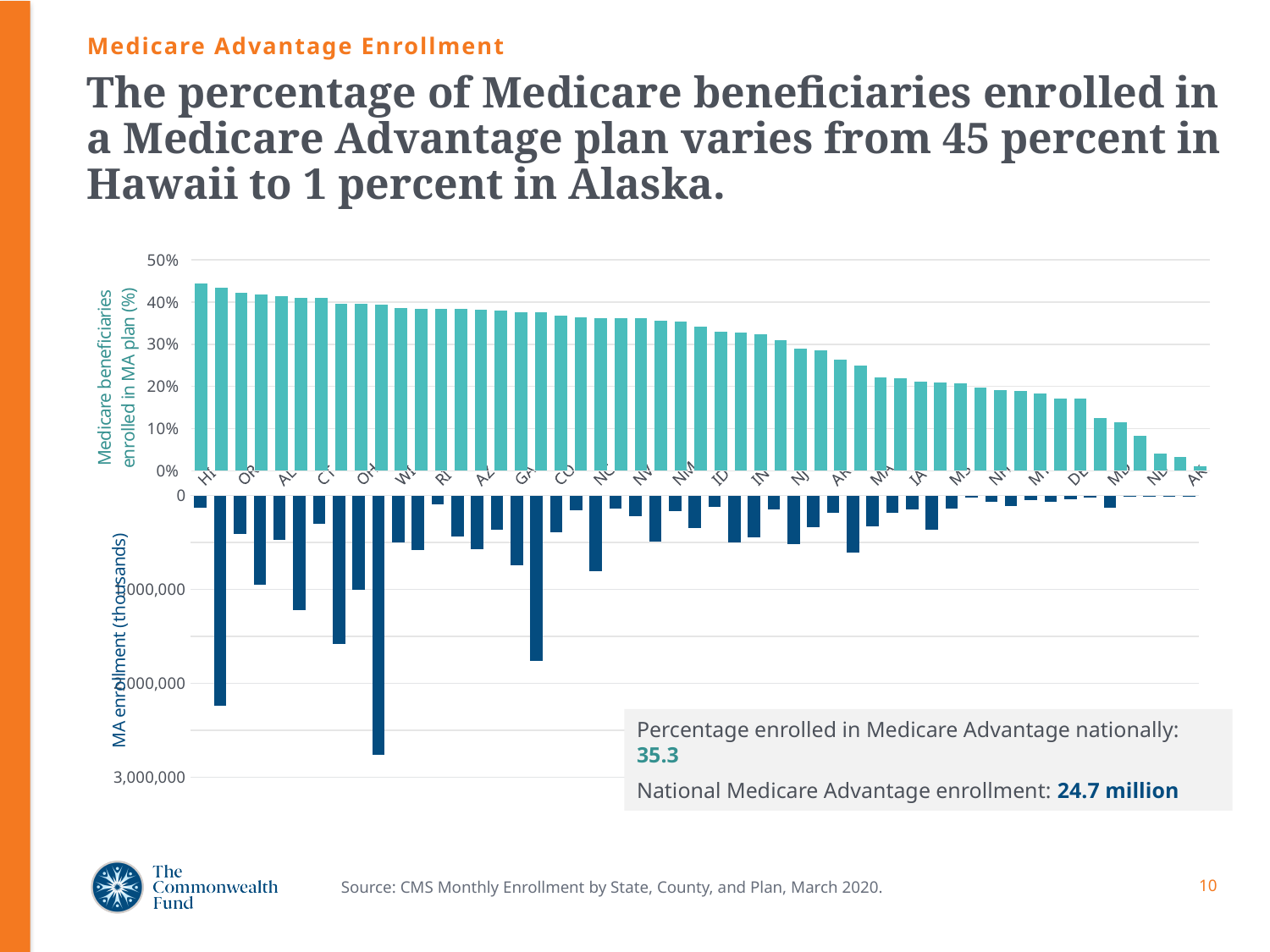
According to the slide, what percentage of Medicare beneficiaries in Alaska are enrolled in a Medicare Advantage plan? 1 percent In the top panel, is the value for DE greater or less than 20%? less In the top panel, do the percentage values rise or fall moving from left to right along the x axis? fall In the top panel, is the value for AR greater or less than 30%? less What is the y-axis label of the top panel of the chart? Medicare beneficiaries enrolled in MA plan (%) According to the slide, what percentage of Medicare beneficiaries in Hawaii are enrolled in a Medicare Advantage plan? 45 percent In the top panel (percentage enrolled in MA plan), which state has the lowest percentage? AK In the top panel (percentage enrolled in MA plan), which state has the highest percentage? HI What kind of chart is shown on the slide? bar chart In the top panel, is the value for ND greater or less than 10%? less In the top panel, which state has a higher percentage enrolled in an MA plan, OR or MD? OR